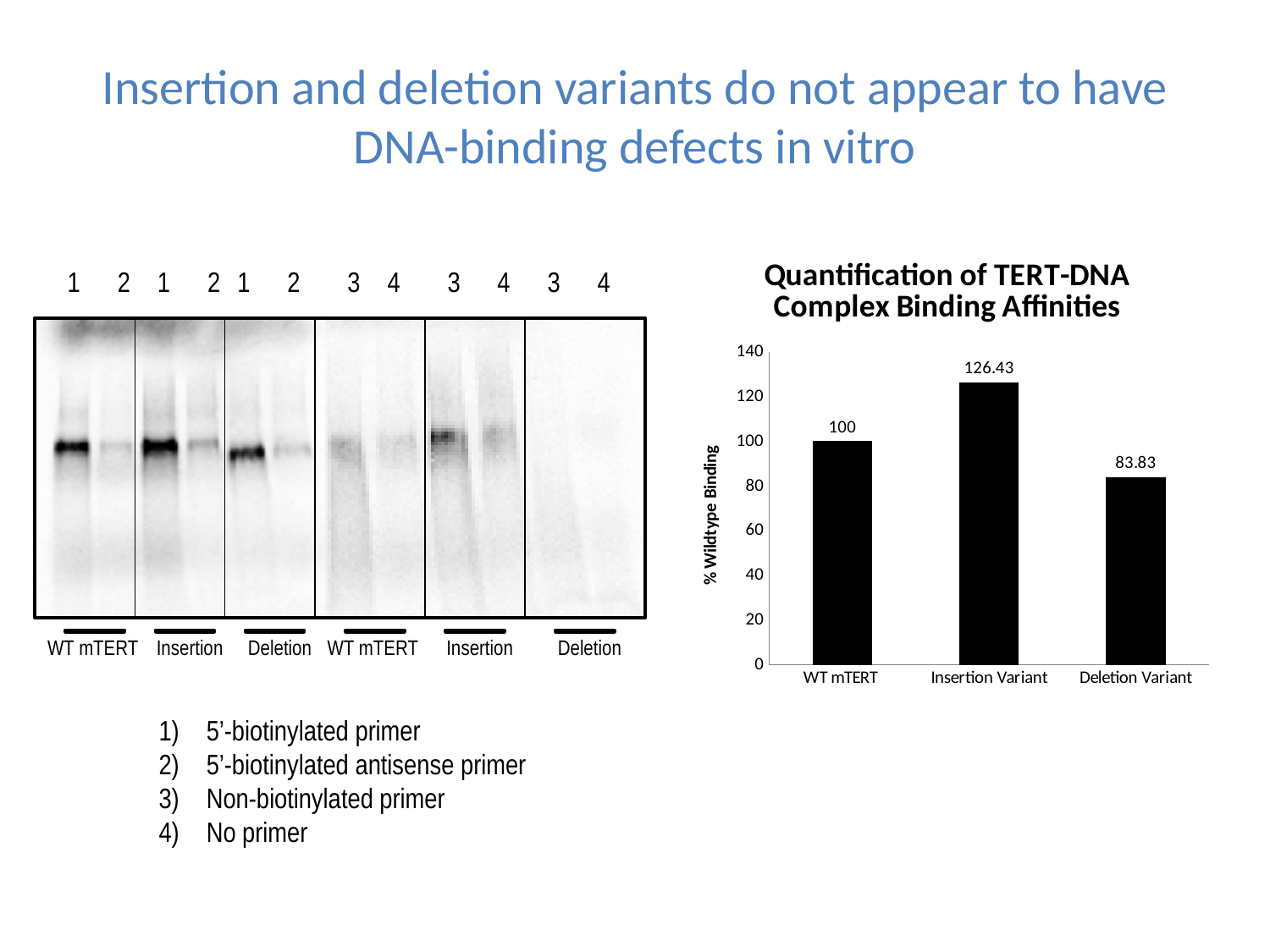
What is the y-axis label of the bar chart? % Wildtype Binding What is the difference between the WT mTERT and Deletion Variant values in the bar chart? 16.17 In the bar chart, which is larger: the value for Insertion Variant or the value for Deletion Variant? Insertion Variant What is the value for WT mTERT in the Quantification of TERT-DNA Complex Binding Affinities chart? 100 Is the value for Deletion Variant in the bar chart greater or less than 100? less How many categories are shown in the bar chart? 3 What is the value for Insertion Variant in the bar chart? 126.43 Which category has the lowest value in the bar chart? Deletion Variant What kind of chart is the Quantification of TERT-DNA Complex Binding Affinities chart? bar chart What is the difference between the Insertion Variant and WT mTERT values in the bar chart? 26.43 What is the value for Deletion Variant in the bar chart? 83.83 Which category has the highest value in the bar chart? Insertion Variant